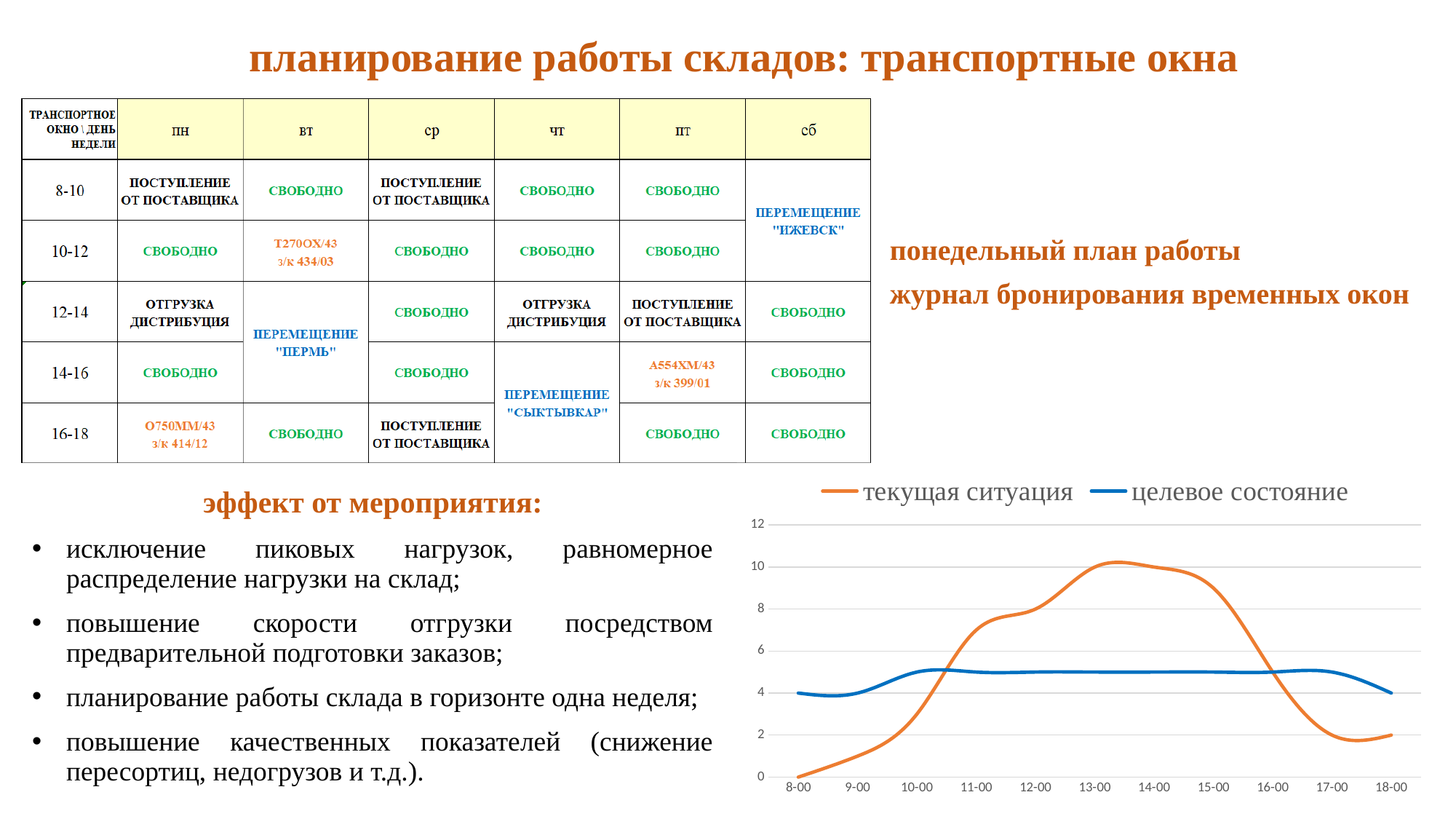
How many time points are shown on the x axis of the line chart? 11 Is the value of 'целевое состояние' at 12-00 greater or less than 4? greater Which colour is used for the 'целевое состояние' series in the line chart? blue Is the value of 'текущая ситуация' at 13-00 greater or less than 8? greater Does the 'текущая ситуация' line rise or fall between 8-00 and 13-00? rise At 14-00, which series has the higher value, 'текущая ситуация' or 'целевое состояние'? текущая ситуация Is the value of 'текущая ситуация' at 17-00 greater or less than 4? less How many series does the legend of the line chart list? 2 Does the 'текущая ситуация' line rise or fall between 15-00 and 17-00? fall At 9-00, which series has the higher value, 'текущая ситуация' or 'целевое состояние'? целевое состояние At which time is the value of 'текущая ситуация' lowest? 8-00 What kind of chart is shown at the bottom right of the slide? line chart